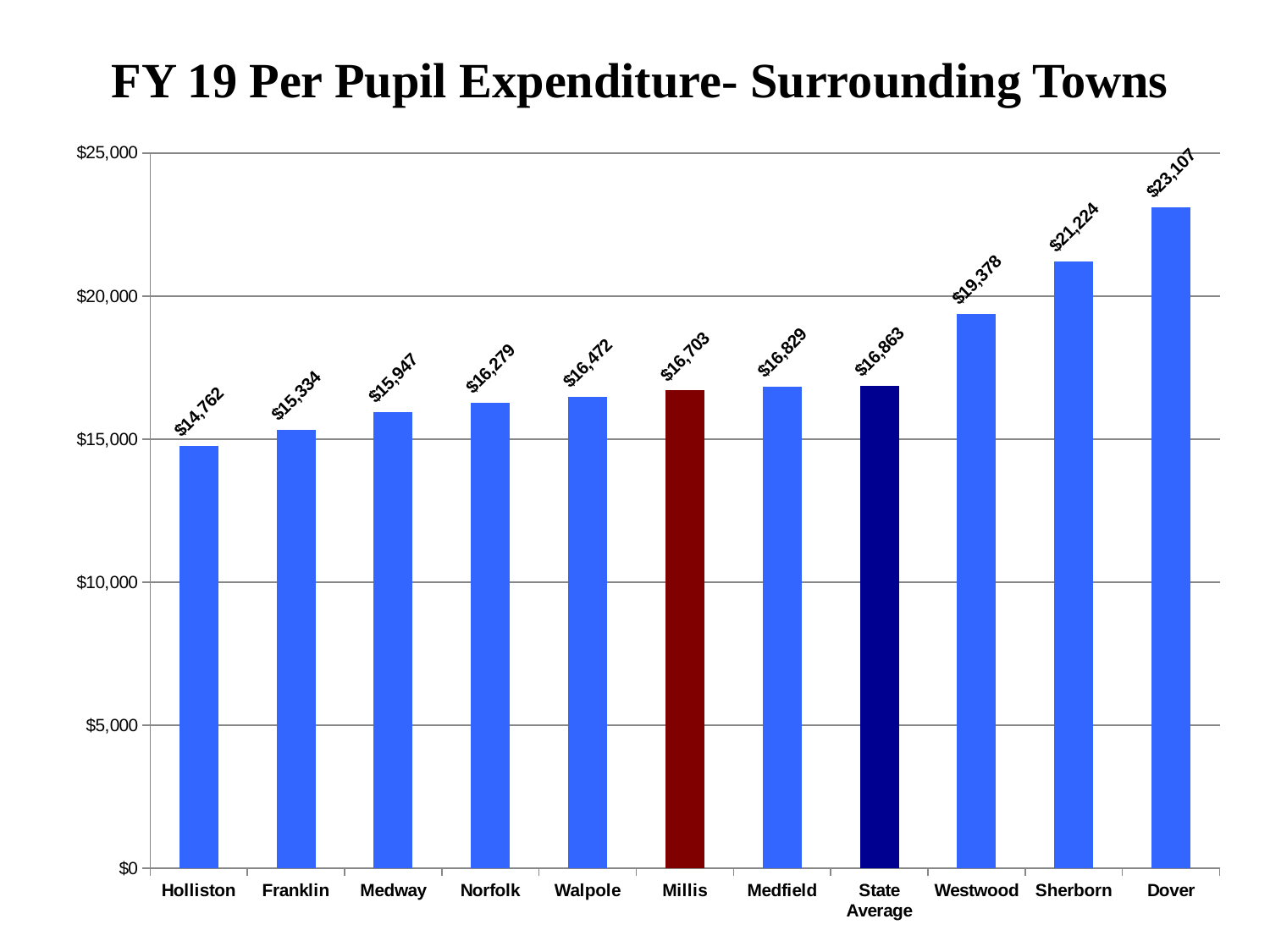
Which has a higher per pupil expenditure, Westwood or Walpole? Westwood How much higher is the State Average than Millis? $160 What kind of chart is shown on the slide? Bar chart Is the value for Sherborn greater or less than $20,000? greater Which bar is coloured dark red? Millis What is the FY 19 per pupil expenditure for Millis? $16,703 Which town has the highest per pupil expenditure? Dover Which town has the lowest per pupil expenditure? Holliston What is the difference between Dover's and Holliston's per pupil expenditure? $8,345 How many towns or categories are shown on the chart? 11 What is the per pupil expenditure shown for the State Average? $16,863 What is the per pupil expenditure for Westwood? $19,378